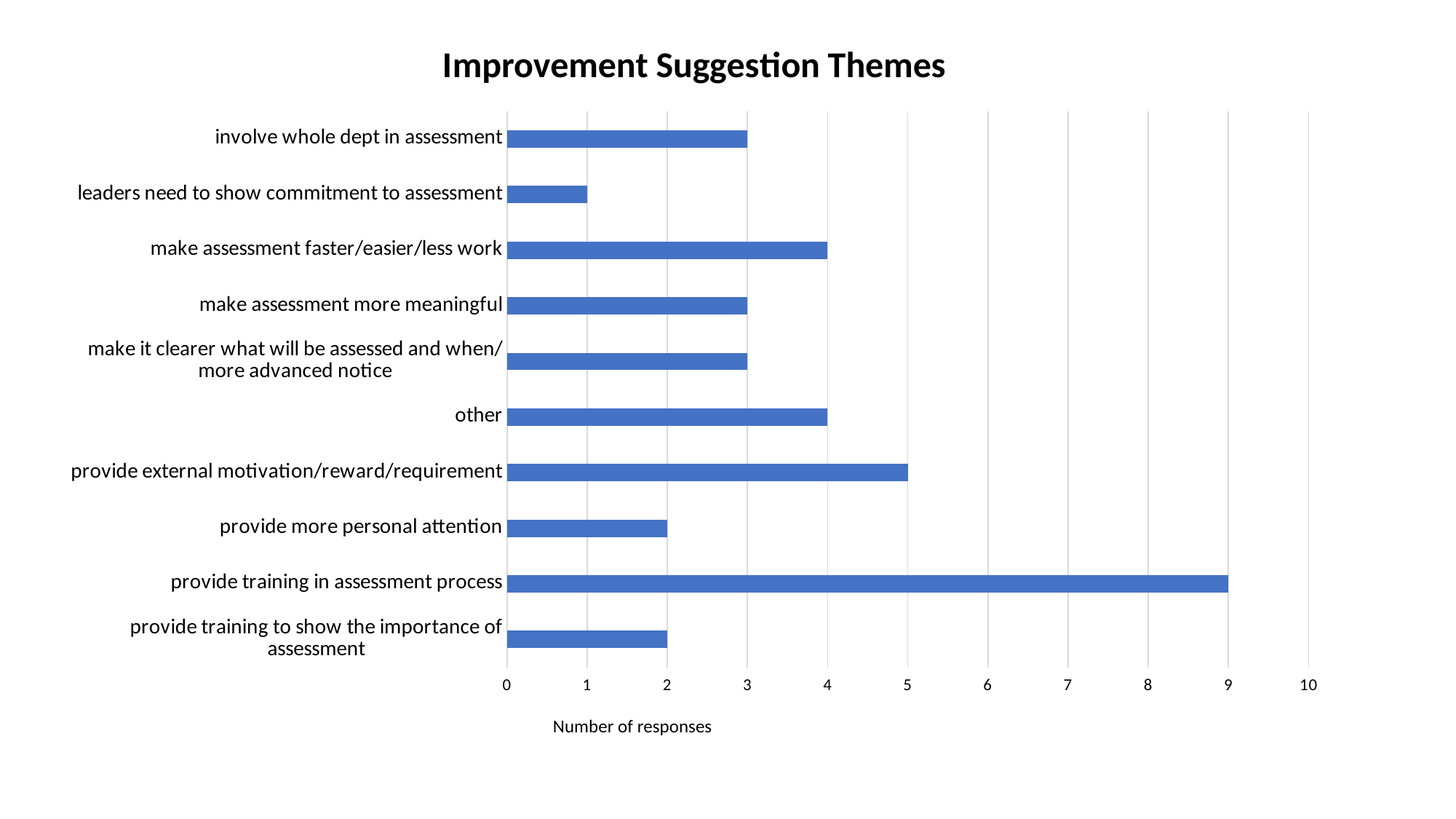
Which has more responses: 'other' or 'provide more personal attention'? other Which category has the highest number of responses? provide training in assessment process What is the difference in responses between 'provide training in assessment process' and 'provide external motivation/reward/requirement'? 4 How many responses are there for 'provide external motivation/reward/requirement'? 5 What is the title of the chart? Improvement Suggestion Themes What type of chart is shown on the slide? bar chart How many responses are there for 'provide training in assessment process'? 9 How many responses are there for 'make assessment faster/easier/less work'? 4 How many categories are shown in the chart? 10 What is the label of the horizontal axis? Number of responses Which category has the lowest number of responses? leaders need to show commitment to assessment Is the value for 'provide training in assessment process' greater or less than 8? greater